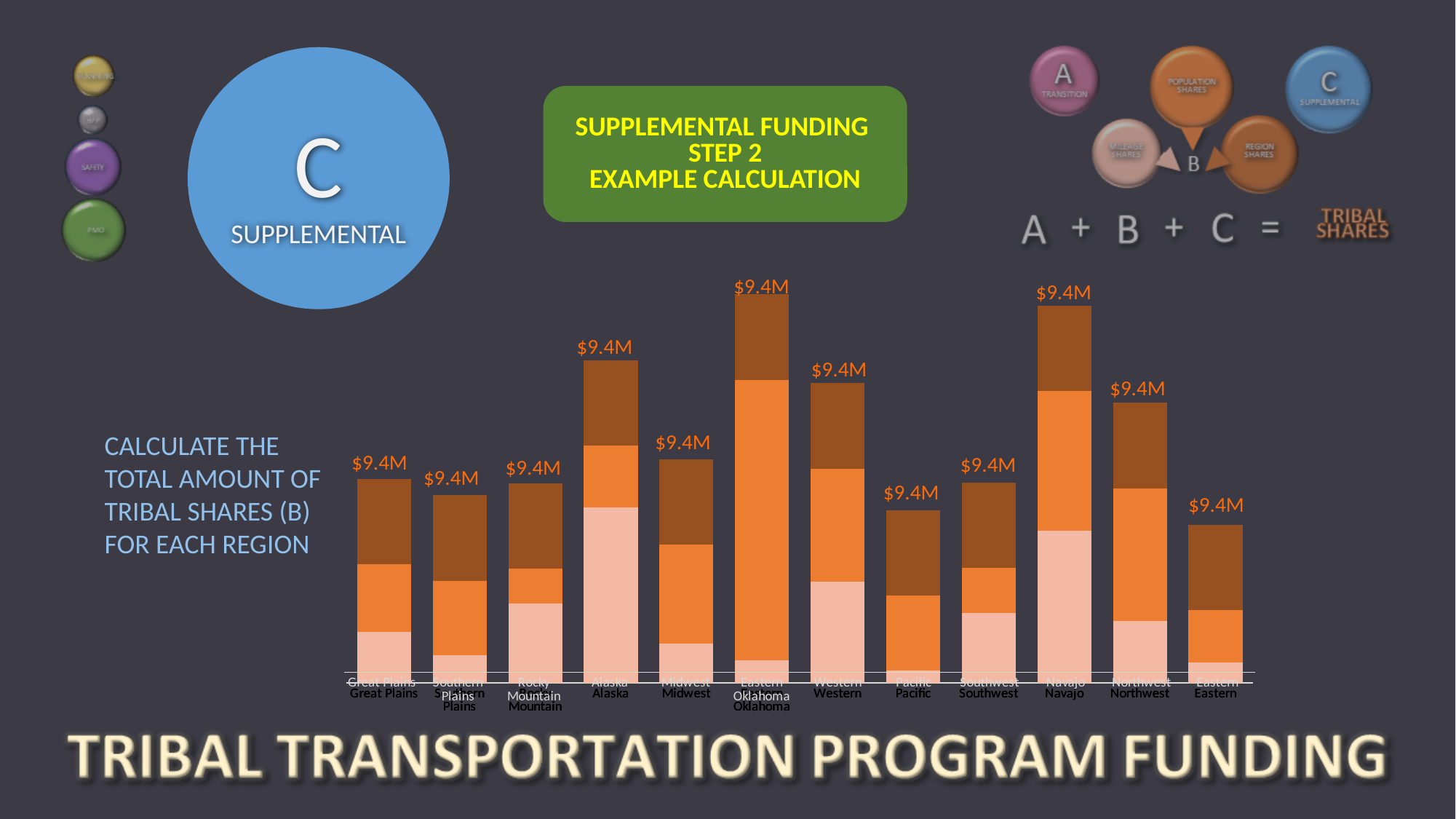
Which region is the last category on the right of the chart? Eastern Which bar is taller overall, Eastern Oklahoma or Pacific? Eastern Oklahoma Which region is the first category on the left of the chart? Great Plains What value is printed above the Eastern bar? $9.4M Which region has the tallest bottom (lightest-coloured) segment? Alaska What value is printed above the Navajo bar? $9.4M How many stacked segments make up each bar in the chart? 3 Which bar is taller overall, Alaska or Midwest? Alaska What kind of chart is shown on the slide? stacked bar chart How many regions (bars) are shown in the chart? 12 What value is printed above the Great Plains bar? $9.4M Which bar is taller overall, Navajo or Southwest? Navajo